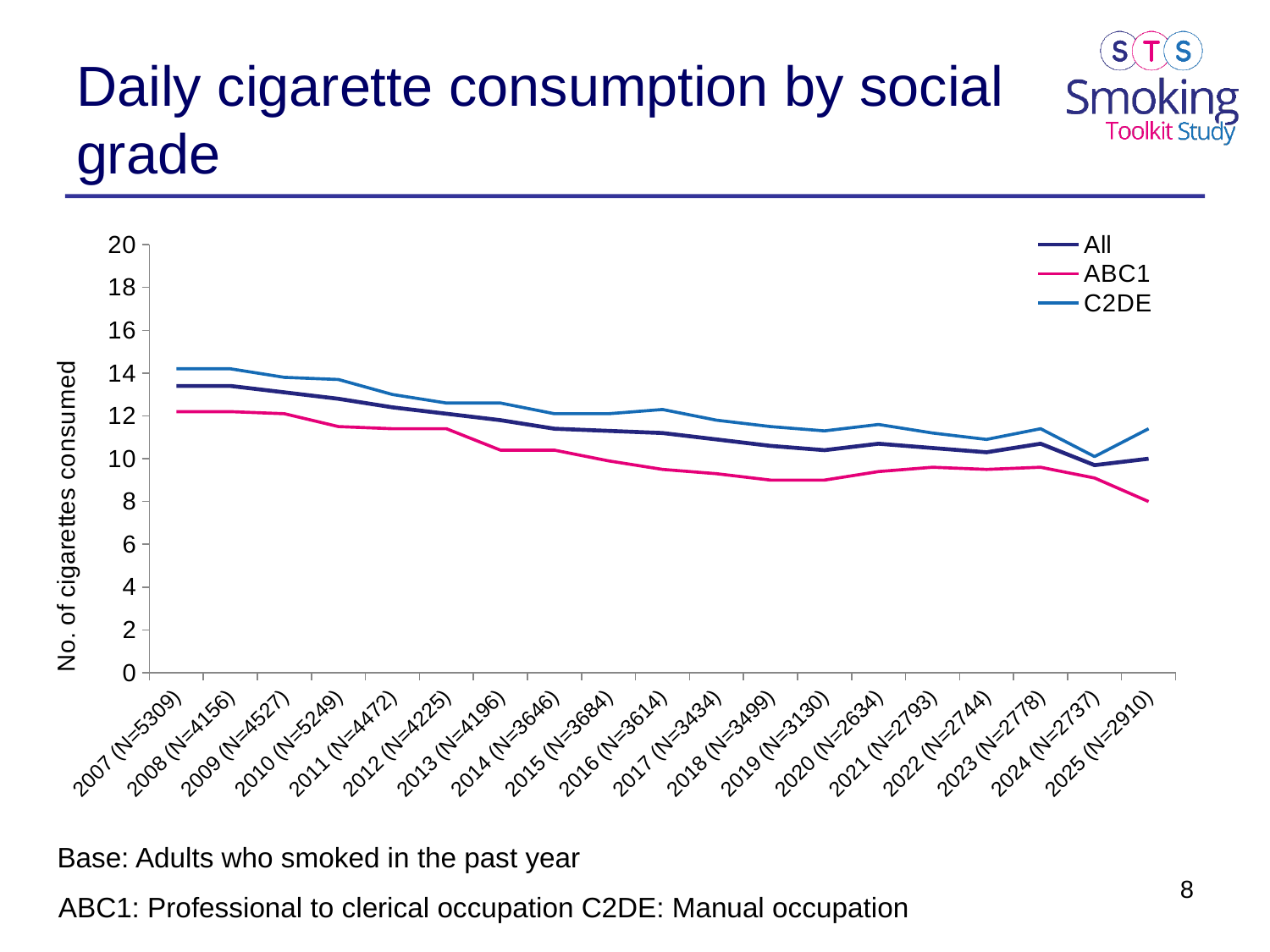
How many series does the legend list? 3 Is the value for ABC1 in 2019 greater or less than 10? less Which series has the highest value in 2025? C2DE What is the label on the y axis? No. of cigarettes consumed In 2007, which series has the larger value, ABC1 or C2DE? C2DE Is the value for All in 2007 greater or less than 12? greater Do the values for the ABC1 series generally rise or fall from 2007 to 2025? Fall What kind of chart is shown on the slide? Line chart Is the value for C2DE in 2025 greater or less than 10? greater How many years are plotted along the x axis? 19 In which year does the ABC1 series reach its lowest value? 2025